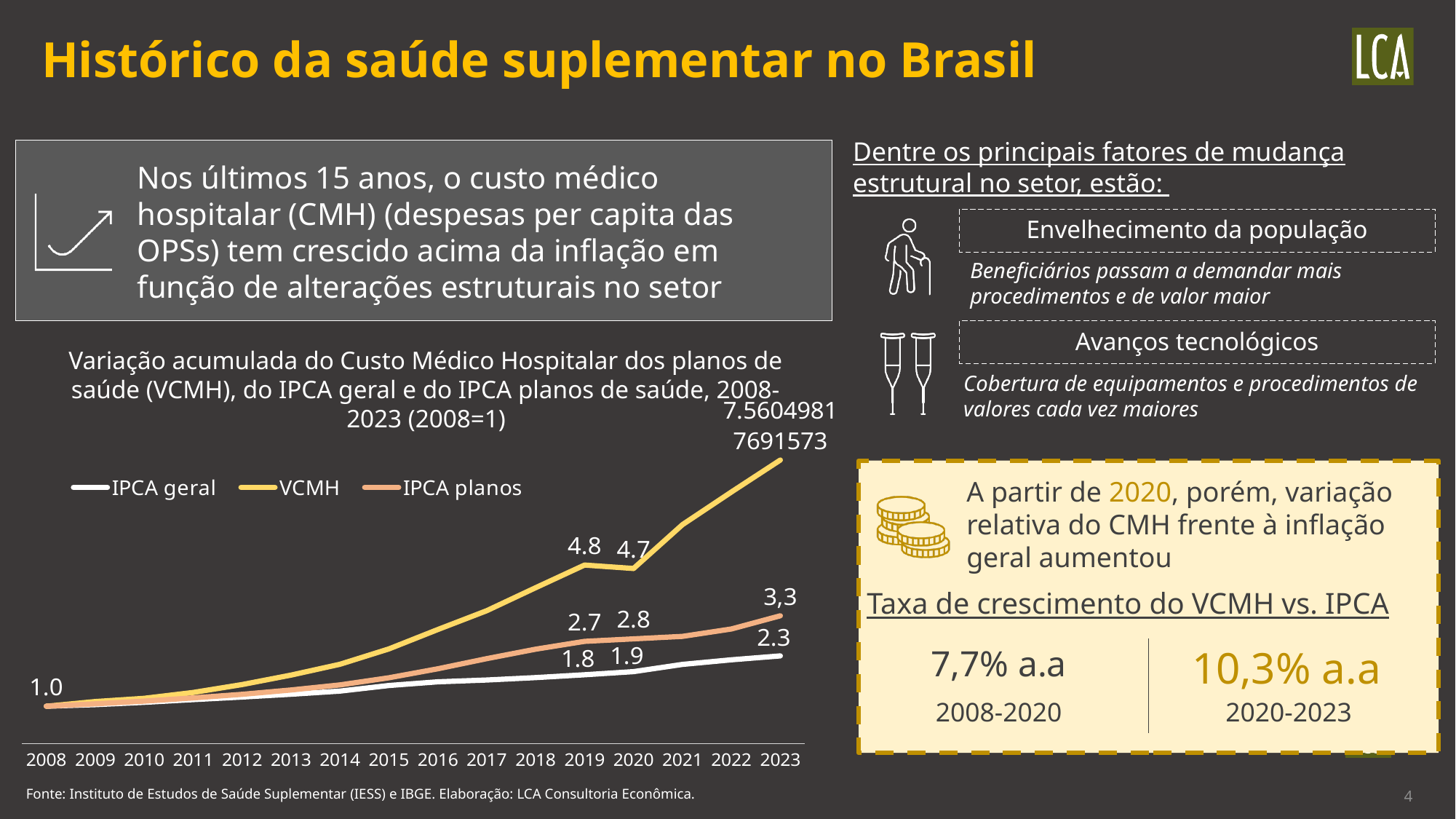
What is the value of IPCA geral in 2023? 2.3 Which is larger in 2020, IPCA planos or IPCA geral? IPCA planos What is the value of IPCA geral in 2019? 1.8 What is the difference between VCMH and IPCA geral in 2019? 3.0 Which series has the highest value in 2023? VCMH What is the value of IPCA planos in 2023? 3,3 How many series does the chart legend list? 3 What is the value of VCMH in 2020? 4.7 What is the value of VCMH in 2019? 4.8 Which series has the lowest value in 2020? IPCA geral How many years are shown on the x axis of the chart? 16 What type of chart is shown on the slide? line chart